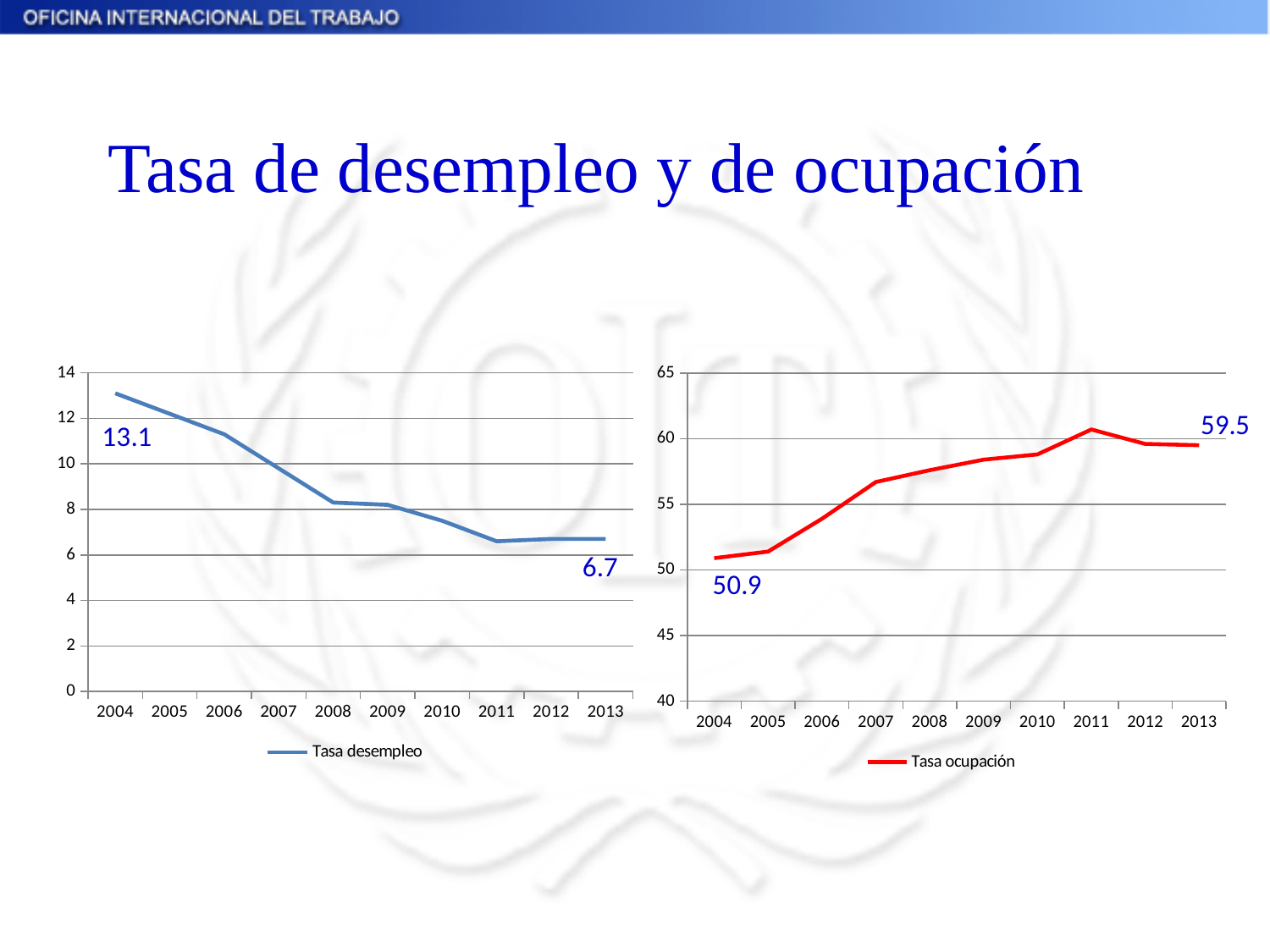
What kind of chart is the right chart (Tasa ocupación)? Line chart In the right chart (Tasa ocupación), what is the value for 2013? 59.5 In the right chart (Tasa ocupación), what is the value for 2004? 50.9 In the right chart (Tasa ocupación), is the value for 2008 greater or less than 55? greater In the left chart (Tasa desempleo), is the value for 2007 greater or less than 12? less In the right chart (Tasa ocupación), by how much did the value rise from 2004 to 2013? 8.6 How many years are plotted on the x axis of the left chart (Tasa desempleo)? 10 In the right chart (Tasa ocupación), which year has the highest value? 2011 In the left chart (Tasa desempleo), which year has the highest value? 2004 In the left chart (Tasa desempleo), what is the value for 2013? 6.7 In the left chart (Tasa desempleo), what is the value for 2004? 13.1 In the left chart (Tasa desempleo), by how much did the value fall from 2004 to 2013? 6.4